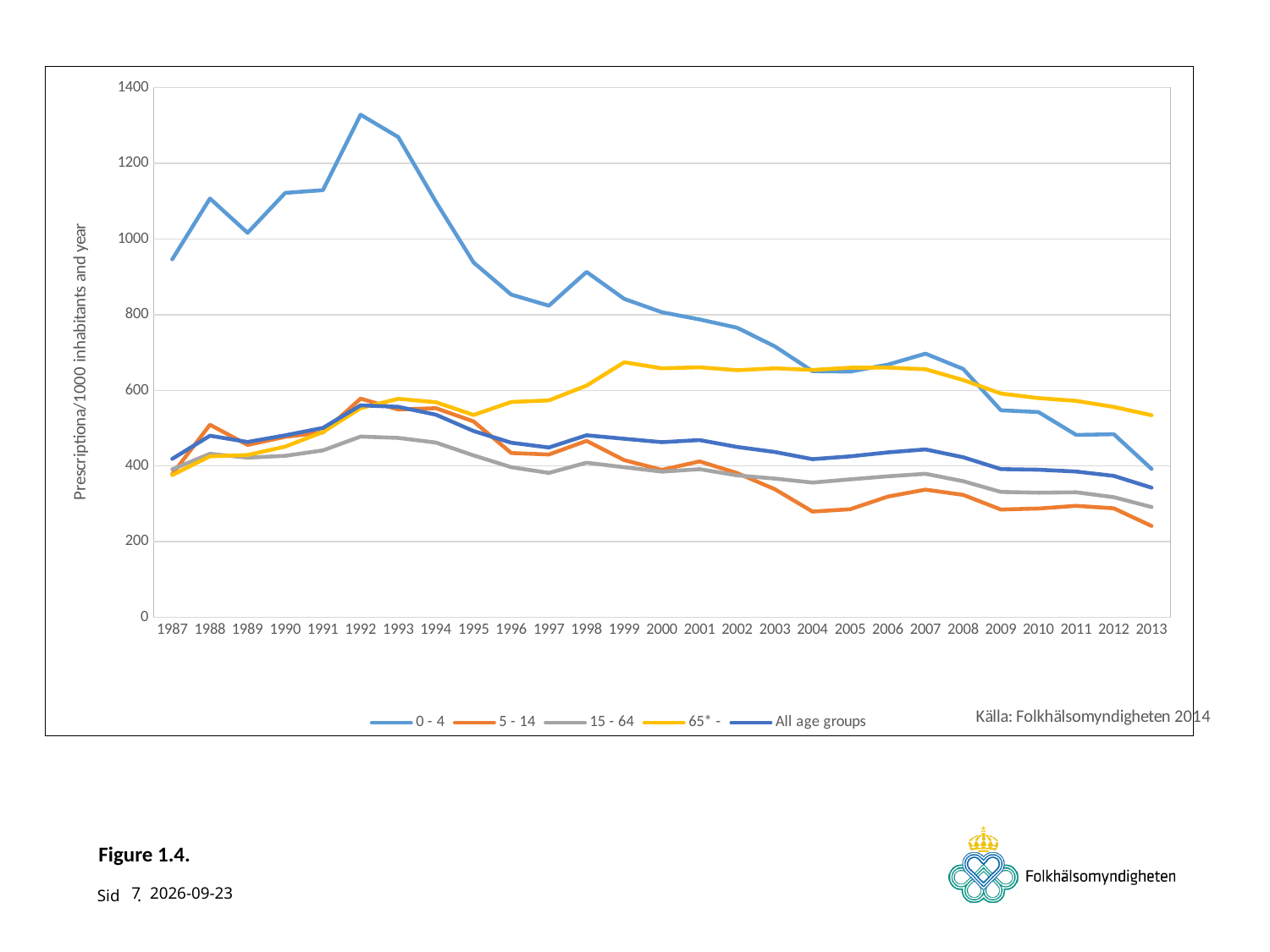
Does the 0 - 4 series rise or fall from 1992 to 2013? fall Which series has the highest value in 2013? 65* - Is the value for the 0 - 4 series in 1987 greater or less than 1000? less How many series does the legend list? 5 Is the value for the 15 - 64 series in 2013 greater or less than 400? less Which series has the highest value in 1992? 0 - 4 What kind of chart is shown on the slide? line chart What is the label on the y axis? Prescriptiona/1000 inhabitants and year Is the value for the 65* - series in 1999 greater or less than 600? greater How many years are shown along the x axis? 27 Which series has the lowest value in 2013? 5 - 14